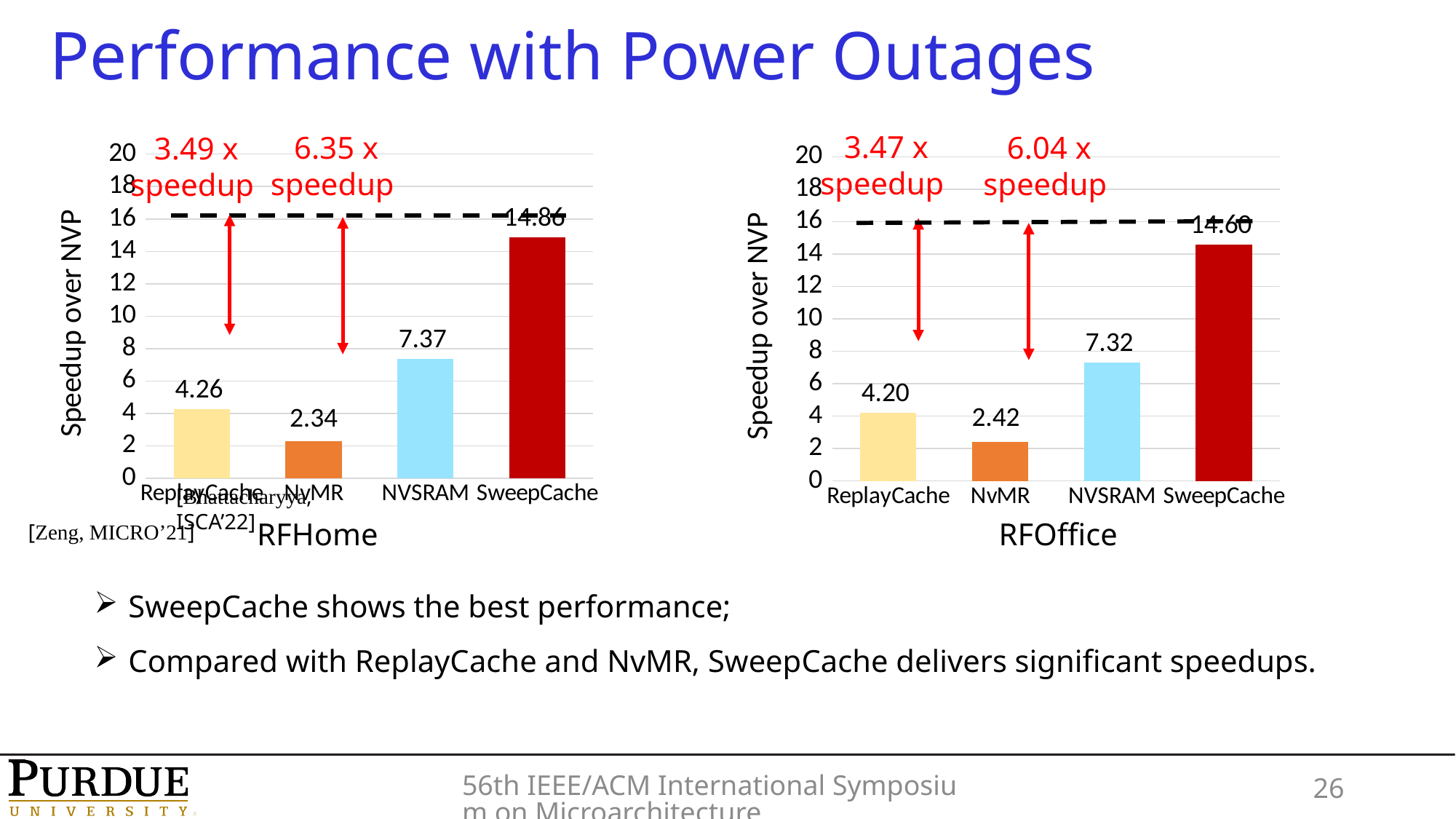
In the RFOffice chart, which is larger, the speedup for NVSRAM or for ReplayCache? NVSRAM In the RFHome chart, what is the speedup over NVP for SweepCache? 14.86 In the RFHome chart, what is the speedup over NVP for NVSRAM? 7.37 In the RFOffice chart, which category has the highest speedup over NVP? SweepCache In the RFOffice chart, what is the speedup over NVP for NvMR? 2.42 In the RFHome chart, which category has the lowest speedup over NVP? NvMR In the RFHome chart, what is the difference between the SweepCache and NVSRAM speedups? 7.49 In the RFOffice chart, what is the speedup over NVP for ReplayCache? 4.20 In the RFOffice chart, what is the difference between the ReplayCache and NvMR speedups? 1.78 What kind of chart is the RFOffice chart? Bar chart What is the y-axis label of the RFHome chart? Speedup over NVP How many categories are shown in the RFHome chart? 4